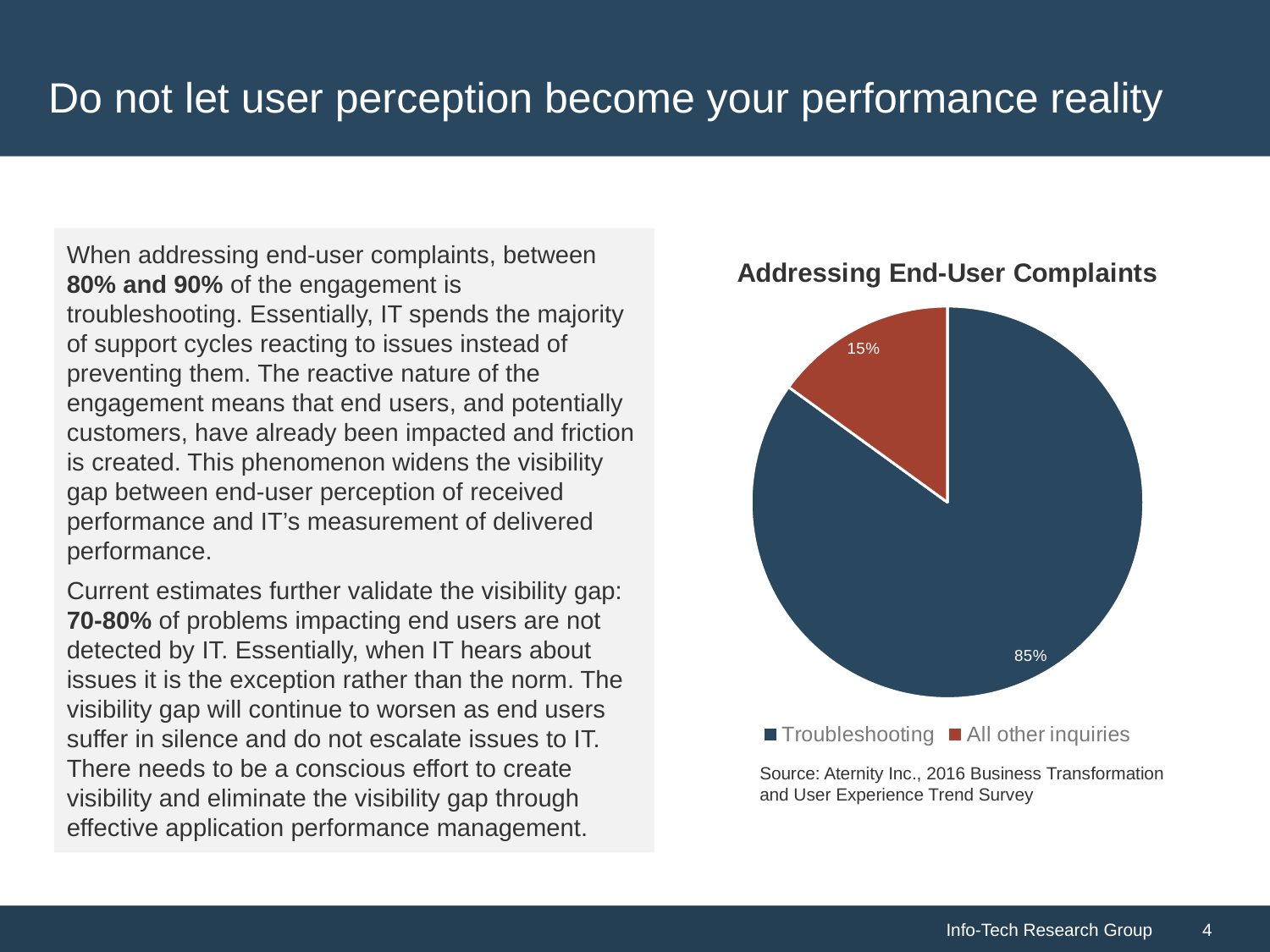
What kind of chart is shown on the slide? Pie chart What is the total of the two slices shown in the pie chart? 100% What is the title of the chart? Addressing End-User Complaints Which slice of the pie is the largest? Troubleshooting What colour is the Troubleshooting slice? Dark blue What is the difference in percentage points between the Troubleshooting slice and the All other inquiries slice? 70 Which is larger, the Troubleshooting slice or the All other inquiries slice? Troubleshooting How many slices does the pie chart have? 2 Which slice of the pie is the smallest? All other inquiries How many entries does the legend list? 2 What share of the pie does All other inquiries account for? 15% What share of the pie does Troubleshooting account for? 85%